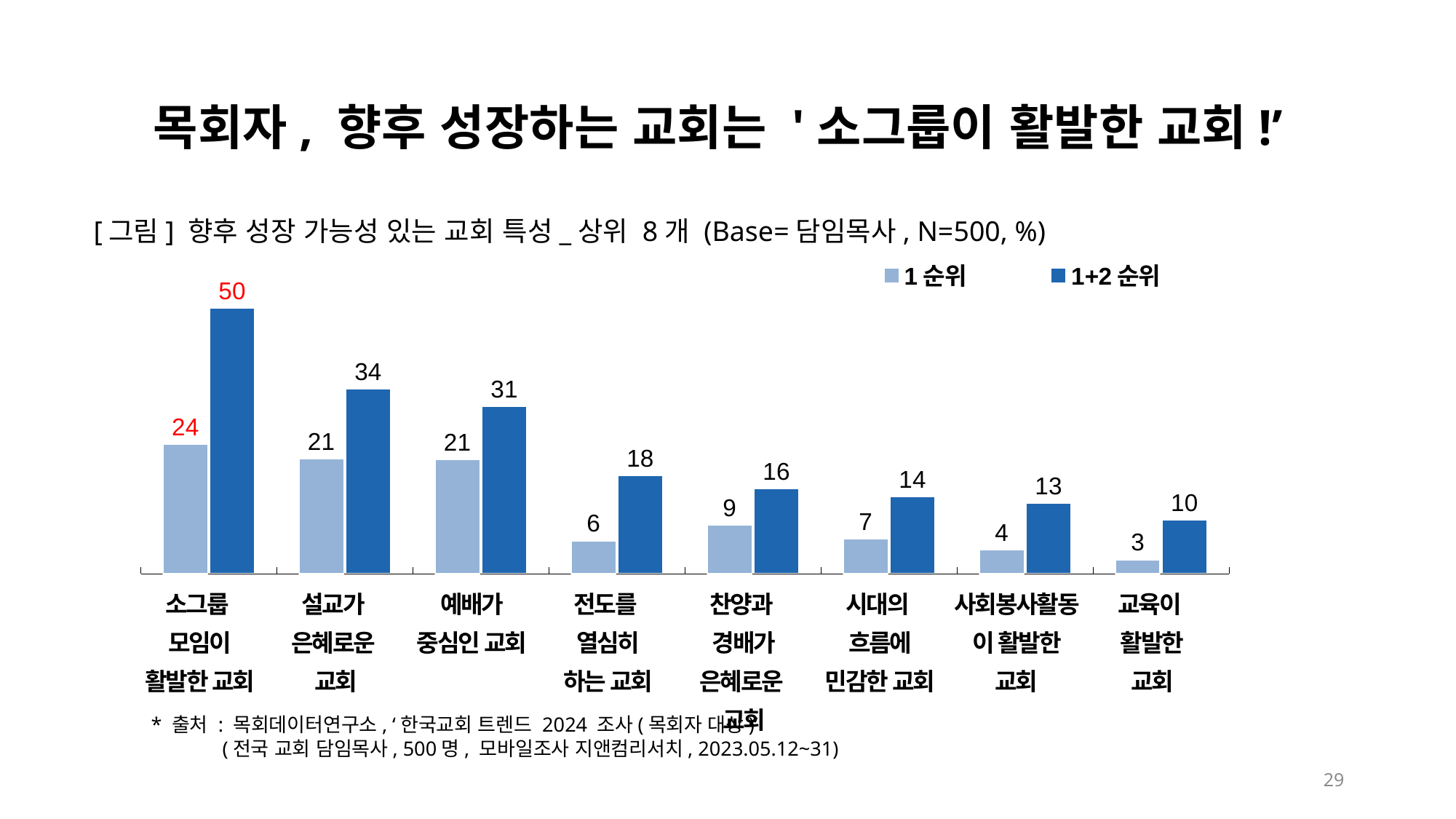
Do the 1+2 순위 values rise or fall from left to right across the categories? Fall How many categories are shown on the chart? 8 Which category has the highest 1+2 순위 value? 소그룹 모임이 활발한 교회 What is the 1+2 순위 value for 전도를 열심히 하는 교회? 18 Which is larger: the 1+2 순위 value for 설교가 은혜로운 교회 or for 예배가 중심인 교회? 설교가 은혜로운 교회 What is the difference between the 1+2 순위 and 1 순위 values for 소그룹 모임이 활발한 교회? 26 What is the 1 순위 value for 교육이 활발한 교회? 3 What is the 1 순위 value for 설교가 은혜로운 교회? 21 What kind of chart is shown on the slide? Bar chart How many series does the legend list? 2 What is the 1+2 순위 value for 소그룹 모임이 활발한 교회? 50 Which category has the lowest 1 순위 value? 교육이 활발한 교회